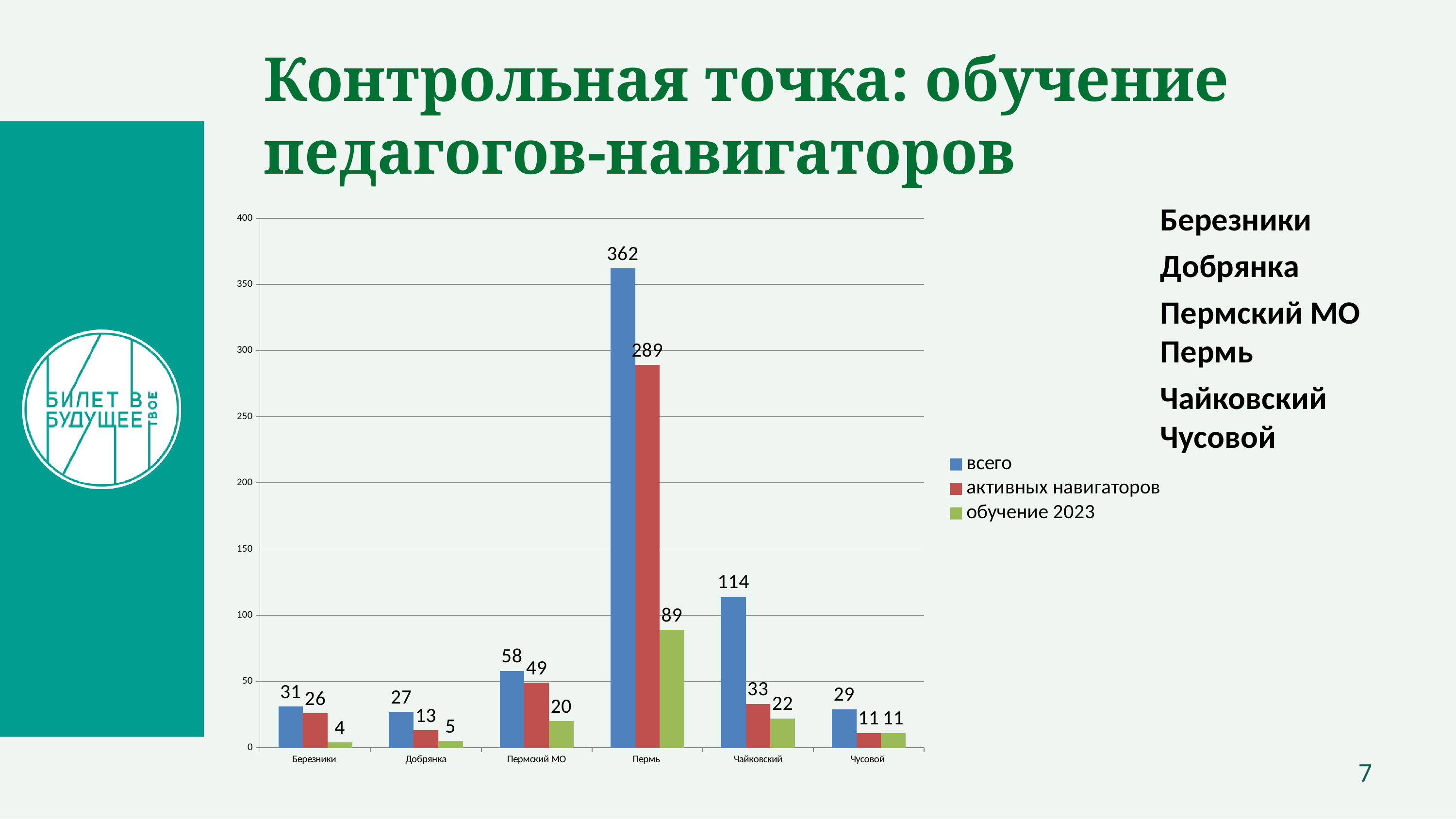
Is the value of "всего" for Пермь greater or less than 350? greater How many categories are shown on the x axis? 6 How many series does the legend list? 3 What is the value of "всего" for Пермь? 362 What kind of chart is shown on the slide? bar chart Which colour represents the "обучение 2023" series? green Which category has the lowest value for "обучение 2023"? Березники What is the value of "активных навигаторов" for Пермский МО? 49 What is the difference between "всего" and "активных навигаторов" for Чайковский? 81 Which is larger: "всего" for Березники or "всего" for Чусовой? Березники What is the value of "обучение 2023" for Чайковский? 22 Which category has the highest value for "всего"? Пермь